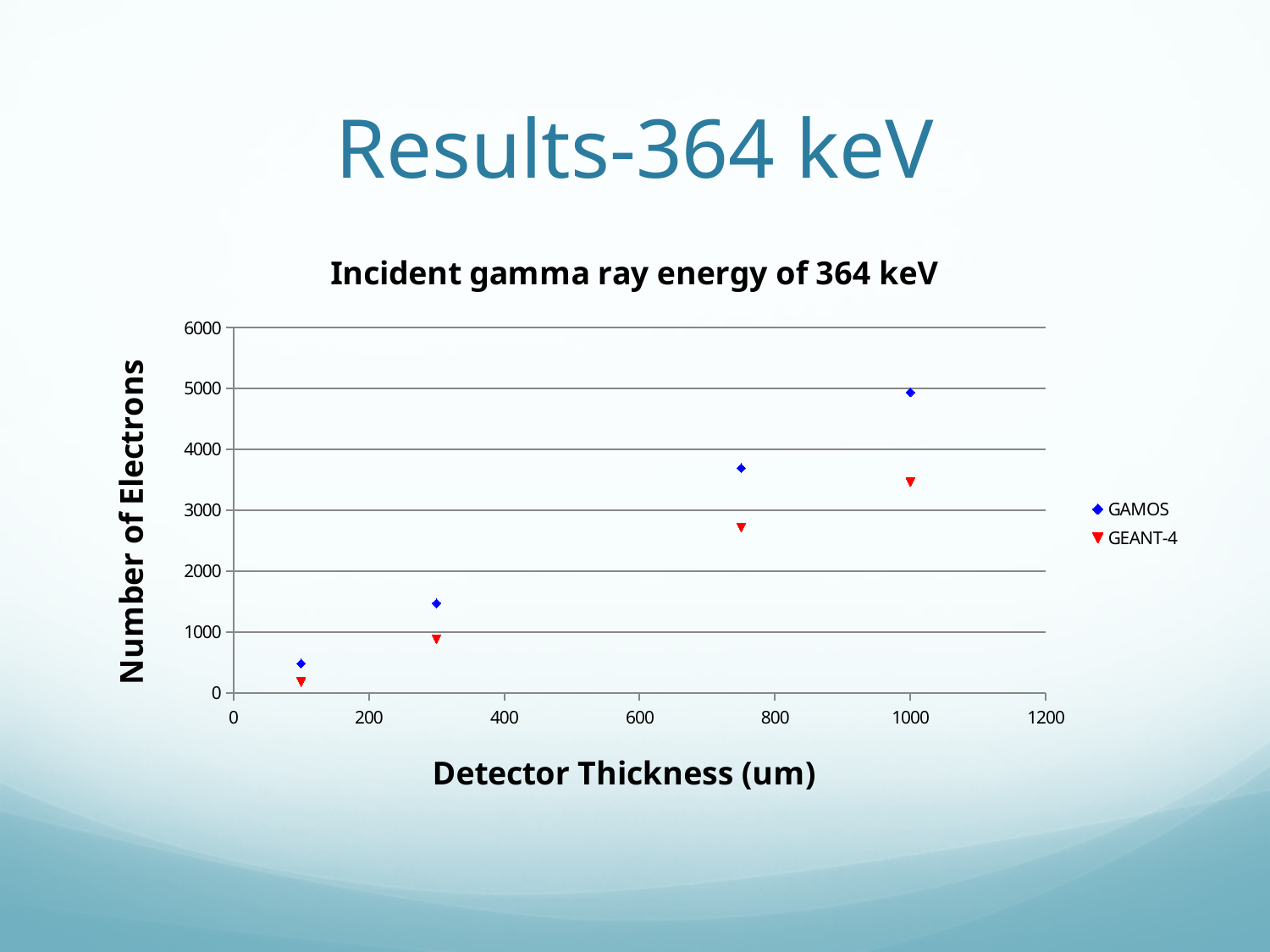
What kind of chart is shown on the slide? scatter chart Is the GAMOS value at a detector thickness of 1000 um greater or less than 4000? greater What is the title of the chart? Incident gamma ray energy of 364 keV How many data points are plotted for the GAMOS series? 4 Is the GEANT-4 value at a detector thickness of 1000 um greater or less than 4000? less How many series does the legend list? 2 Is the GEANT-4 value at a detector thickness of 300 um greater or less than 1000? less At which detector thickness does the GAMOS series reach its highest number of electrons? 1000 um Do the number of electrons rise or fall as detector thickness increases? rise At a detector thickness of 1000 um, which series has the larger number of electrons, GAMOS or GEANT-4? GAMOS